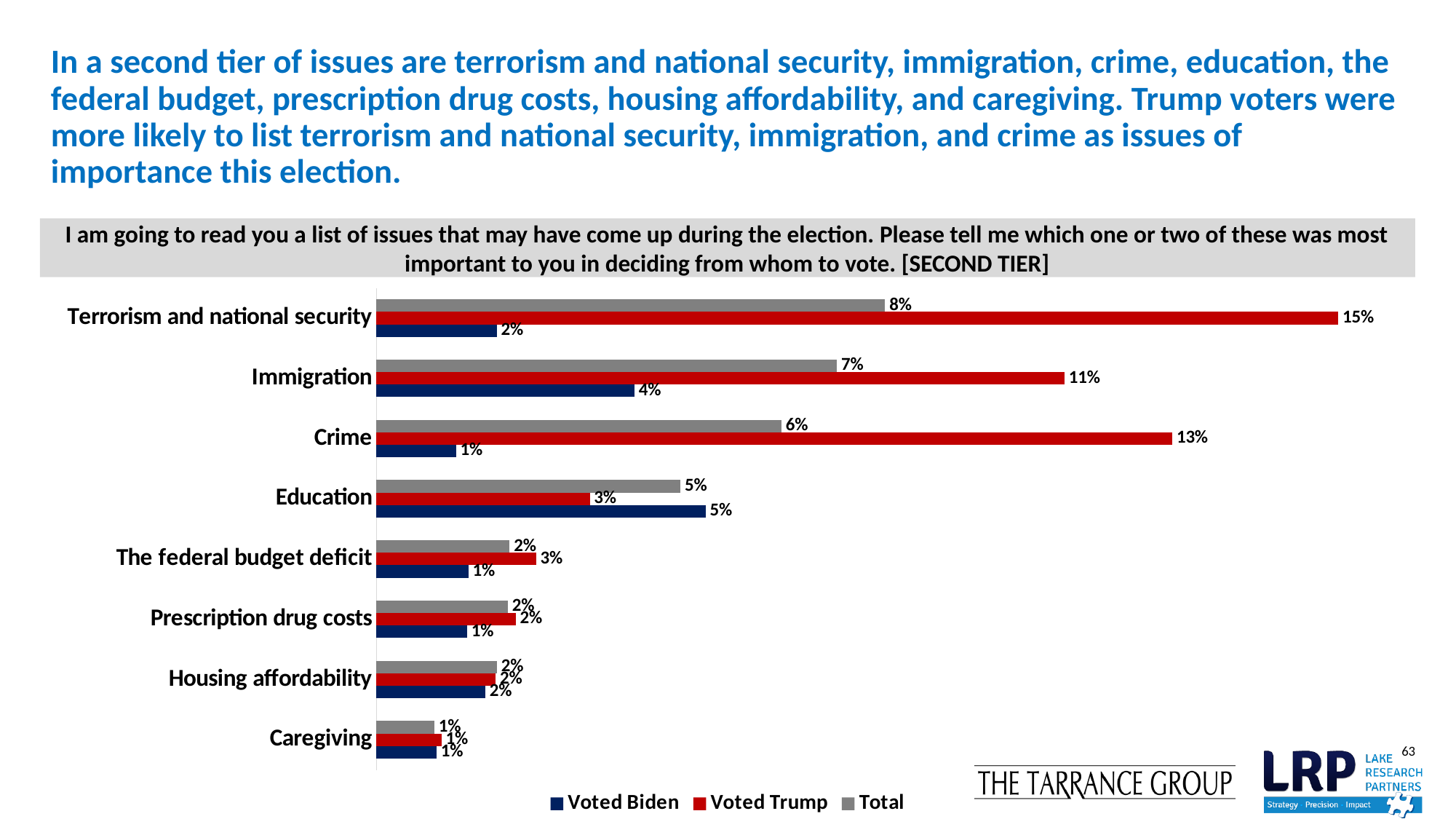
Which issue has the highest Voted Trump value? Terrorism and national security Which colour represents the Voted Trump series? Red How many series does the legend list? 3 Which issue has the lowest Total value? Caregiving How many issues are listed on the chart? 8 What kind of chart is shown on the slide? Bar chart What percentage of Biden voters listed Education? 5% What percentage of Trump voters listed terrorism and national security as a most important issue? 15% What is the Voted Trump value for Crime? 13% What is the difference between the Voted Trump and Voted Biden values for Crime? 12% What is the Total value for Immigration? 7% For Immigration, which is larger: the Voted Biden value or the Voted Trump value? Voted Trump